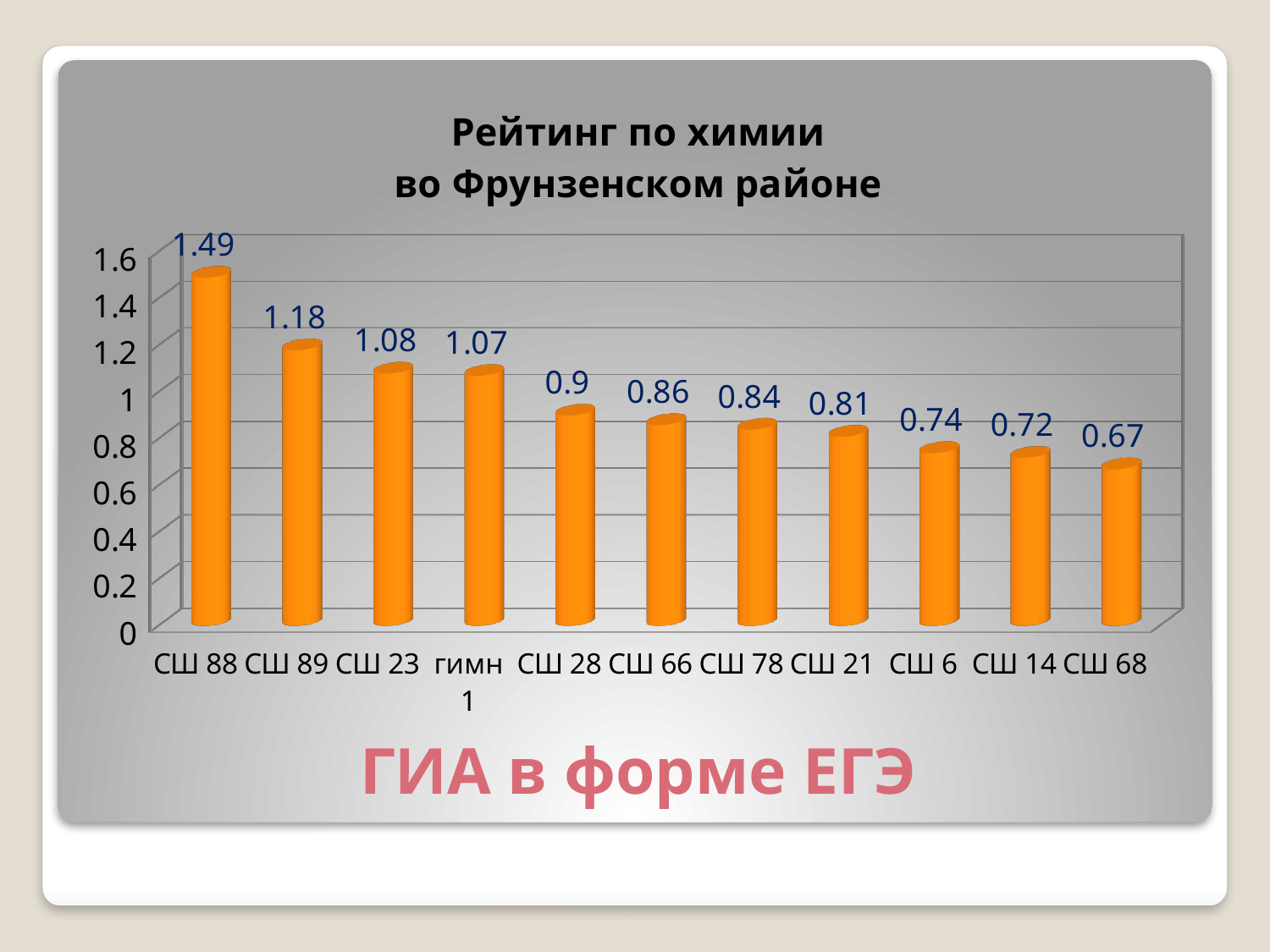
What is the difference between the values for СШ 88 and СШ 89? 0.31 Which school has the lowest rating? СШ 68 Which school has the highest rating? СШ 88 What is the value for СШ 88? 1.49 How many schools are shown on the chart? 11 Which is larger, the value for СШ 28 or the value for СШ 6? СШ 28 What is the value for СШ 78? 0.84 What is the value for гимн 1? 1.07 What is the title of the chart? Рейтинг по химии во Фрунзенском районе What kind of chart is this? bar chart What is the value for СШ 68? 0.67 Do the values rise or fall from left to right along the x axis? fall